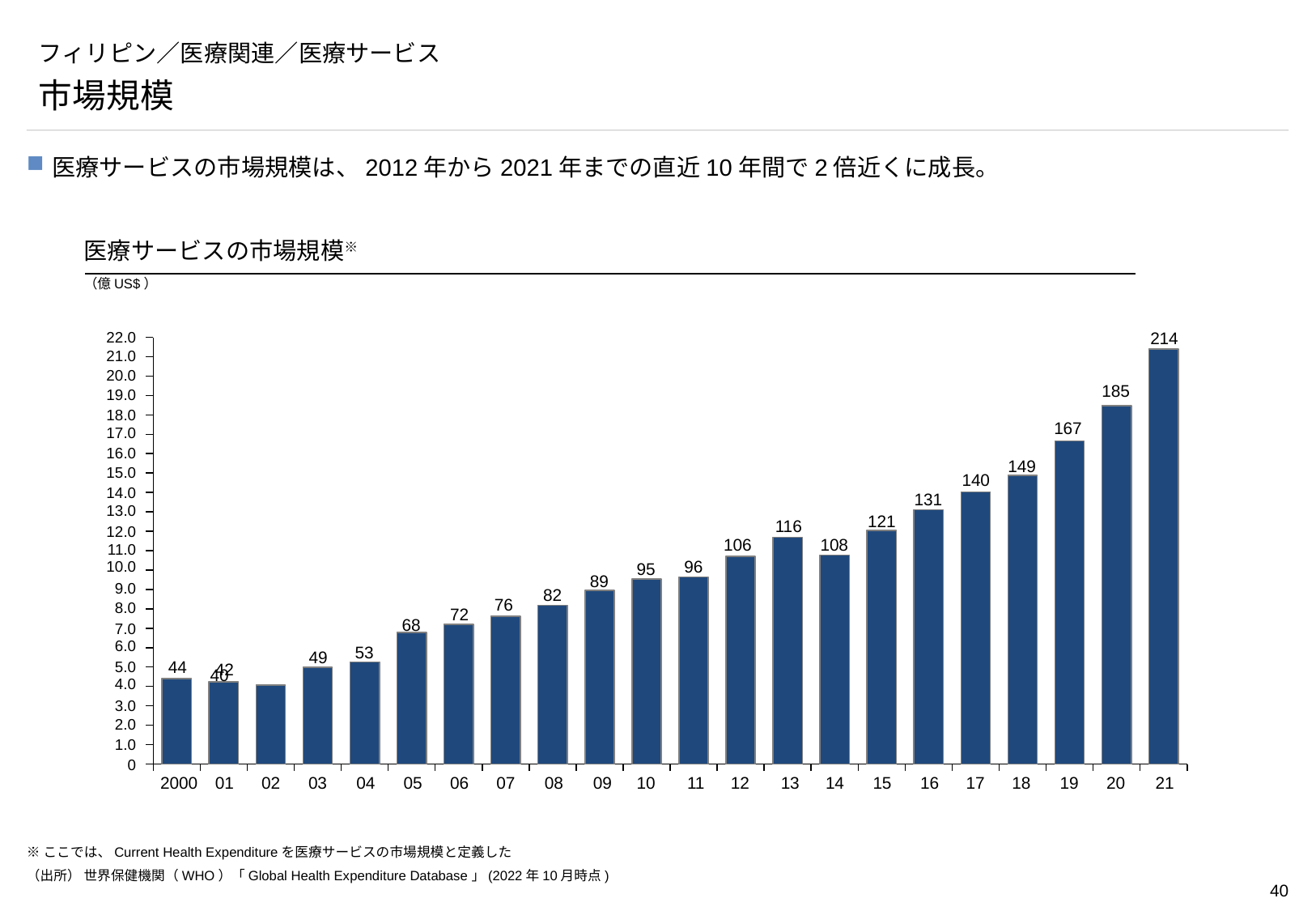
What is the difference between the values for 21 and 12? 108 What is the value for 2000 in the chart? 44 What unit is shown for the chart values? 億US$ What is the difference between the values for 20 and 19? 18 What is the value for 14 in the chart? 108 Which year has the highest value in the chart? 21 Which is larger, the value for 13 or the value for 14? 13 Do the values generally rise or fall from 2000 to 21? Rise What kind of chart is shown on the slide? Bar chart What is the value for 12 in the chart? 106 What is the value for 21 in the chart? 214 How many bars (years) are shown in the chart? 22